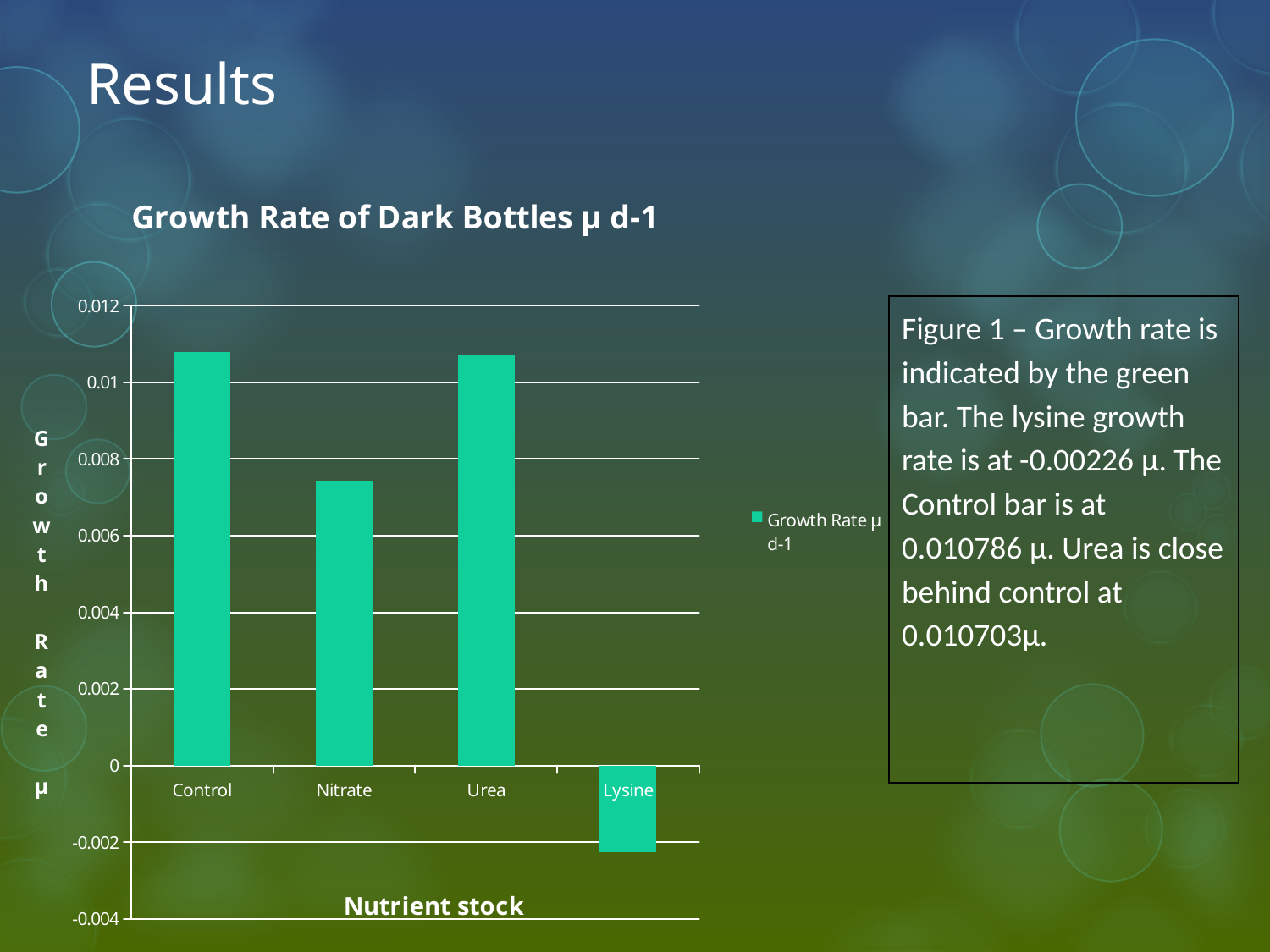
According to the slide, what is the growth rate of the Control bar? 0.010786 μ Which nutrient stock has the lowest growth rate? Lysine How many nutrient stock categories are plotted on the chart? 4 What is the title of the chart? Growth Rate of Dark Bottles μ d-1 What kind of chart is shown on the slide? bar chart Is the growth rate for Nitrate greater or less than 0.008? less Which has the larger growth rate, Urea or Lysine? Urea How many series does the chart legend list? 1 According to the slide, what is the growth rate of the Lysine bar? -0.00226 μ Is the growth rate for Nitrate greater or less than 0.006? greater Which has the larger growth rate, Control or Nitrate? Control Is the growth rate for Lysine greater or less than 0? less